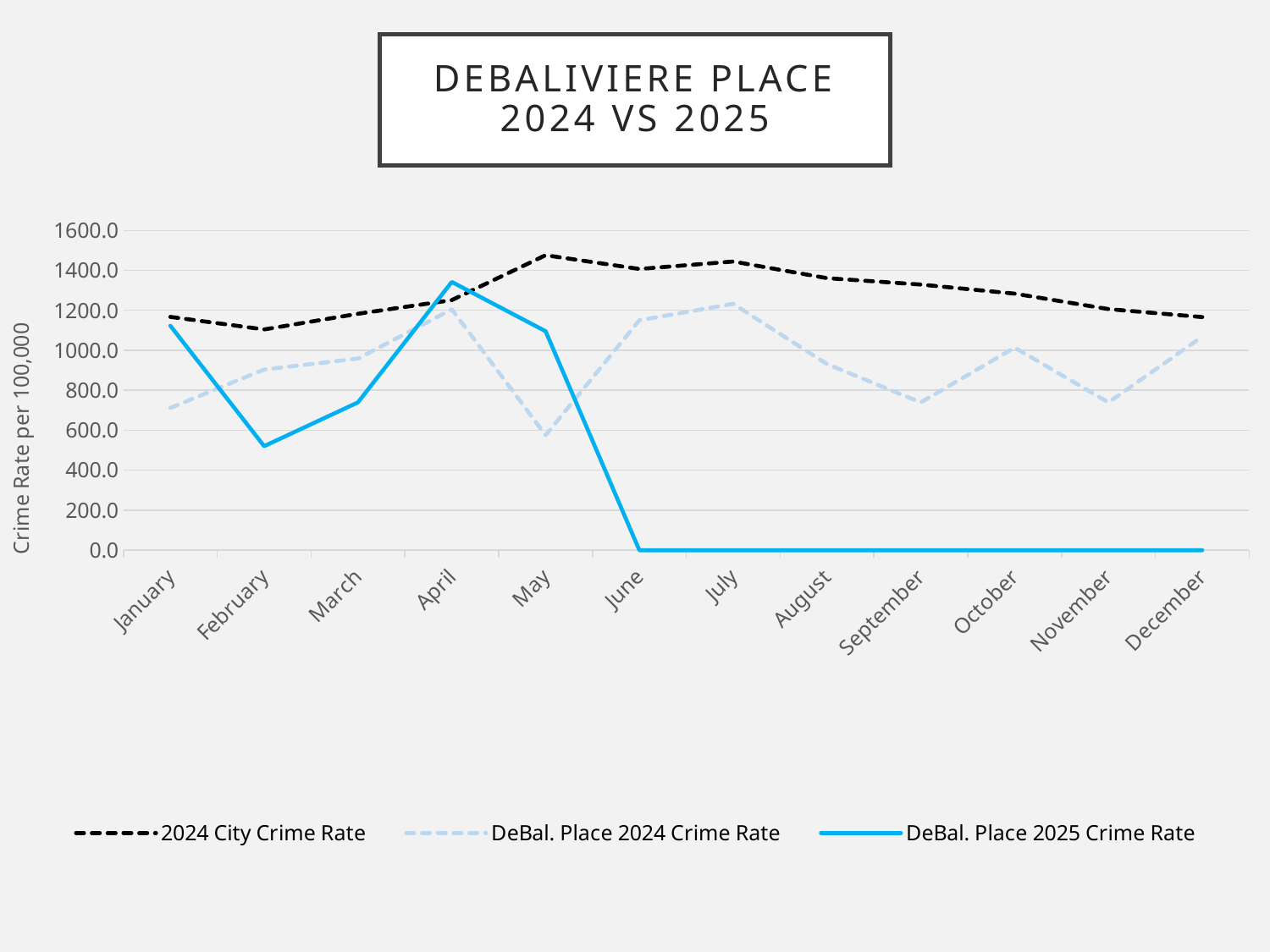
In which month is the 2024 City Crime Rate highest? May Is the DeBal. Place 2024 Crime Rate for January greater or less than 800.0? less In February, which is higher: the DeBal. Place 2024 Crime Rate or the DeBal. Place 2025 Crime Rate? DeBal. Place 2024 Crime Rate How many series does the legend list? 3 What is the DeBal. Place 2025 Crime Rate value for December? 0.0 In which month is the DeBal. Place 2025 Crime Rate highest? April How many months are plotted along the x axis? 12 What is the DeBal. Place 2025 Crime Rate value for June? 0.0 What is the label on the vertical axis? Crime Rate per 100,000 In which month is the DeBal. Place 2024 Crime Rate lowest? May What kind of chart is shown on the slide? Line chart Is the 2024 City Crime Rate for May greater or less than 1400.0? greater